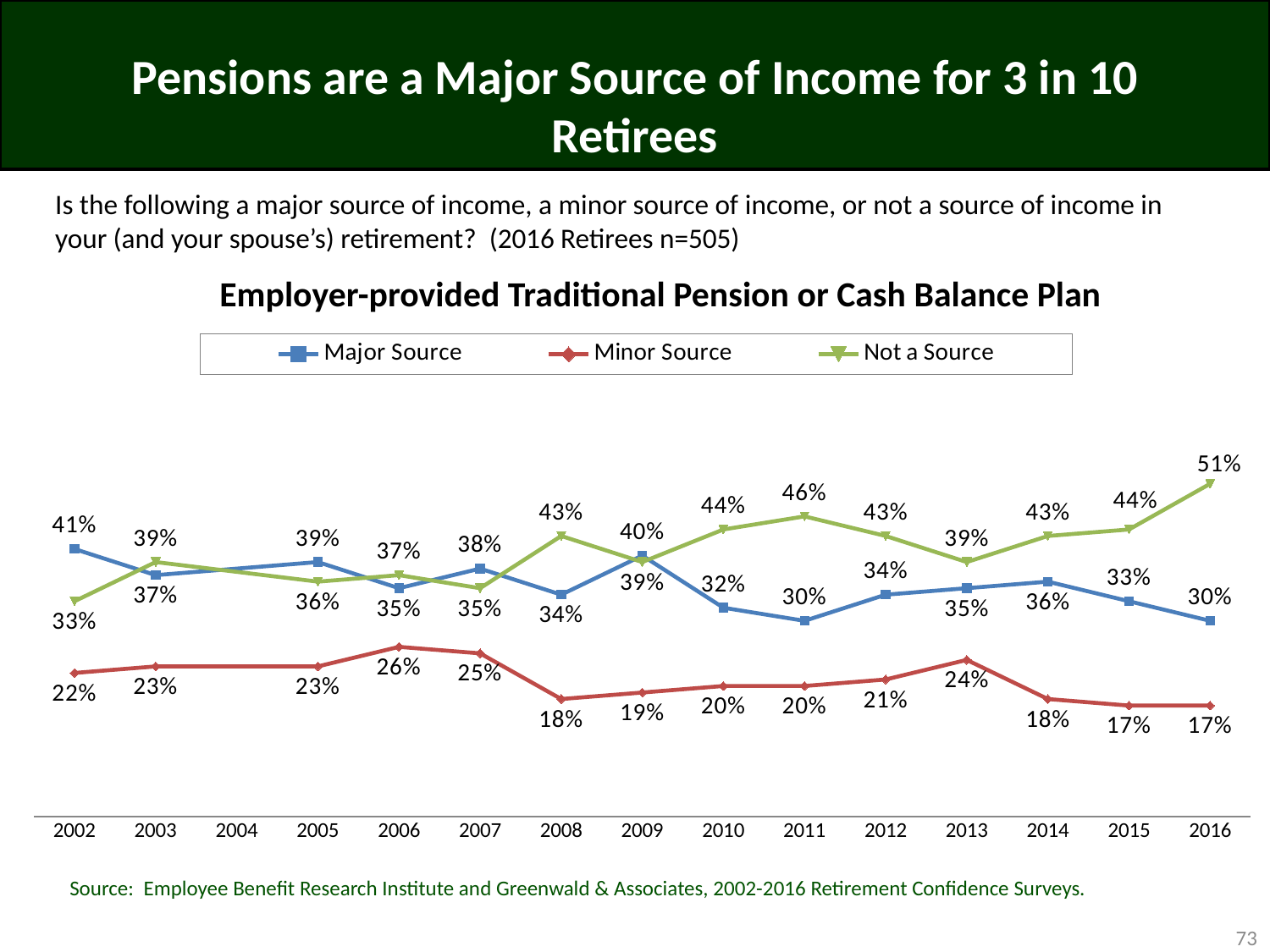
Does the Major Source line generally rise or fall from 2002 to 2016? fall In which year is the Major Source value highest? 2002 What type of chart is shown on the slide? line chart What is the difference between the Not a Source and Major Source values in 2016? 21 percentage points What is the value for Not a Source in 2016? 51% How many series does the legend list? 3 What is the value for Major Source in 2002? 41% What is the value for Minor Source in 2013? 24% Which is larger in 2011, the Not a Source value or the Major Source value? Not a Source In which year is the Not a Source value highest? 2016 What is the title of the chart? Employer-provided Traditional Pension or Cash Balance Plan What is the difference between the Minor Source values in 2007 and 2008? 7 percentage points